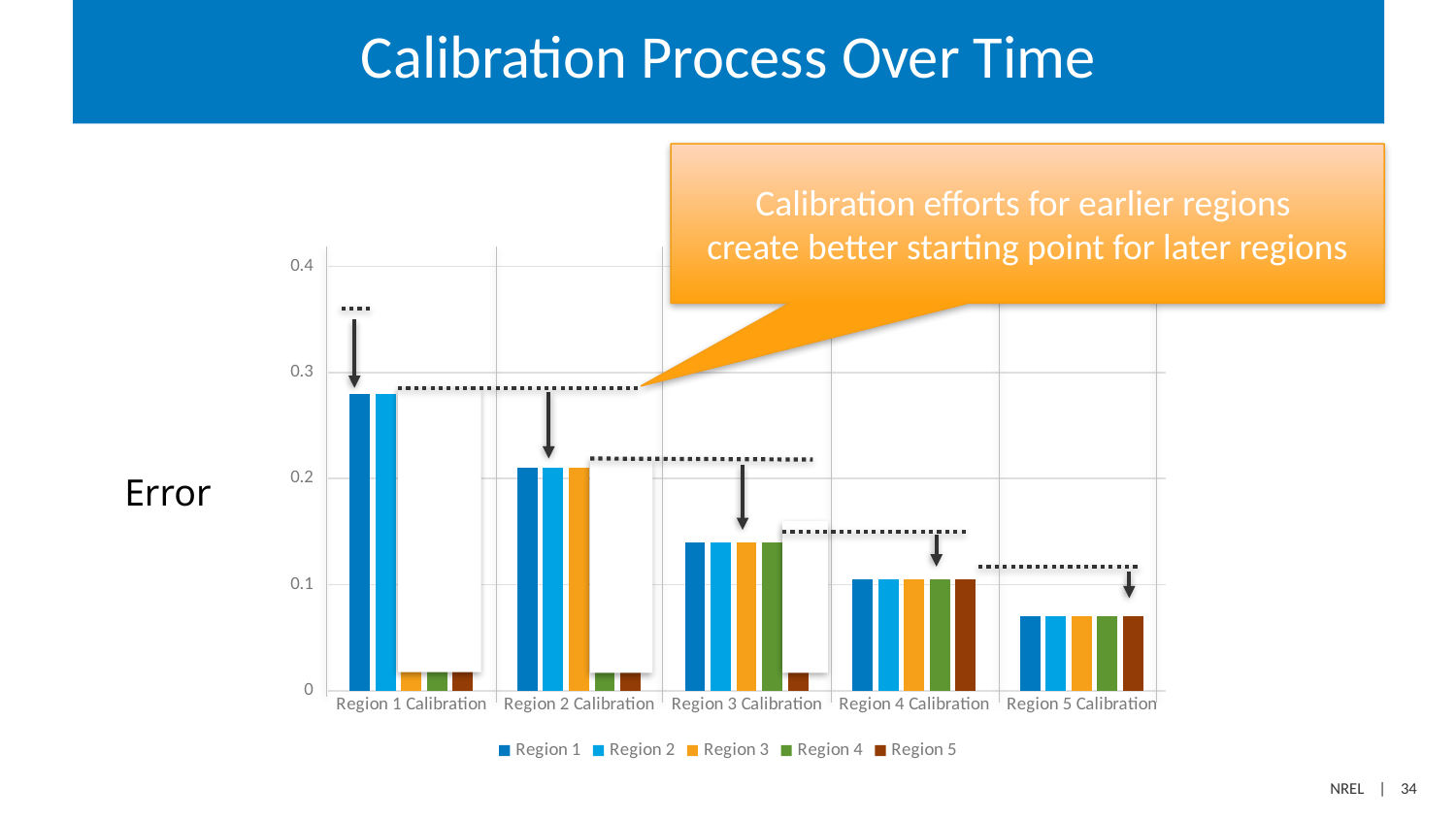
How many series does the chart's legend list? 5 Is the value for Region 1 in the Region 1 Calibration category greater or less than 0.2? greater Is the value for Region 1 in the Region 3 Calibration category greater or less than 0.2? less What label is shown on the vertical axis of the chart? Error Do the values for the Region 1 series rise or fall from Region 1 Calibration to Region 5 Calibration? fall Is the value for Region 1 in the Region 5 Calibration category greater or less than 0.1? less In which category is the value for the Region 1 series highest? Region 1 Calibration What kind of chart is shown on the slide? bar chart What is the title of the chart on the slide? Calibration Process Over Time How many categories are shown on the x axis of the chart? 5 In which category is the value for the Region 1 series lowest? Region 5 Calibration